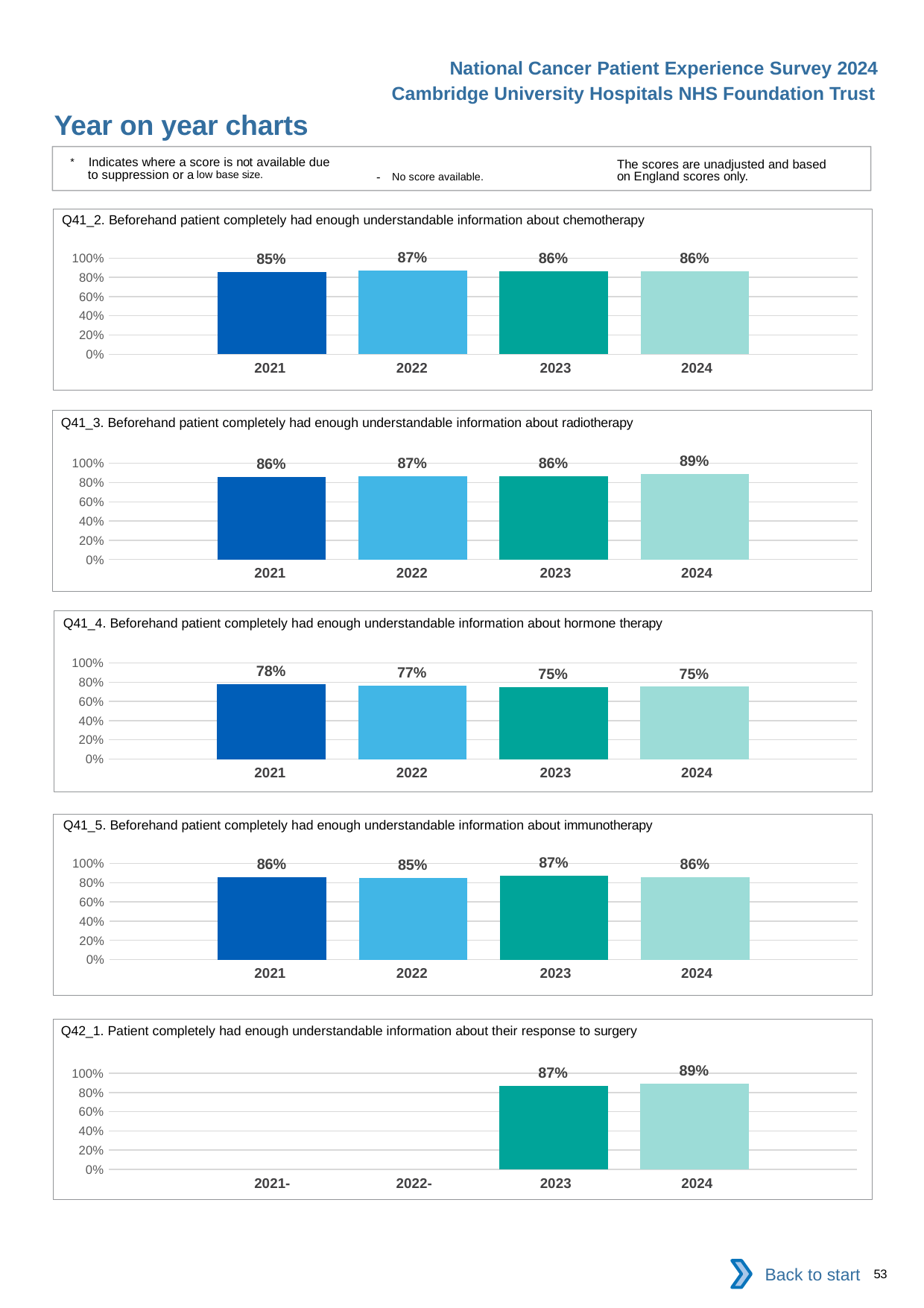
In the Q41_2 chart (chemotherapy), what is the difference between the 2022 and 2021 values? 2% What kind of chart is the Q41_2 chart (chemotherapy)? bar chart In the Q42_1 chart (response to surgery), what is the value for 2024? 89% In the Q41_4 chart (hormone therapy), do the values generally rise or fall from 2021 to 2024? fall In the Q41_5 chart (immunotherapy), what is the value for 2023? 87% In the Q41_3 chart (radiotherapy), what is the difference between the 2024 and 2023 values? 3% In the Q41_2 chart (chemotherapy), what is the value for 2022? 87% In the Q42_1 chart (response to surgery), is the 2023 value larger or smaller than the 2024 value? smaller In the Q41_5 chart (immunotherapy), which year has the lowest value? 2022 In the Q42_1 chart (response to surgery), how many years have a bar plotted? 2 In the Q41_3 chart (radiotherapy), which year has the highest value? 2024 In the Q41_4 chart (hormone therapy), what is the value for 2021? 78%